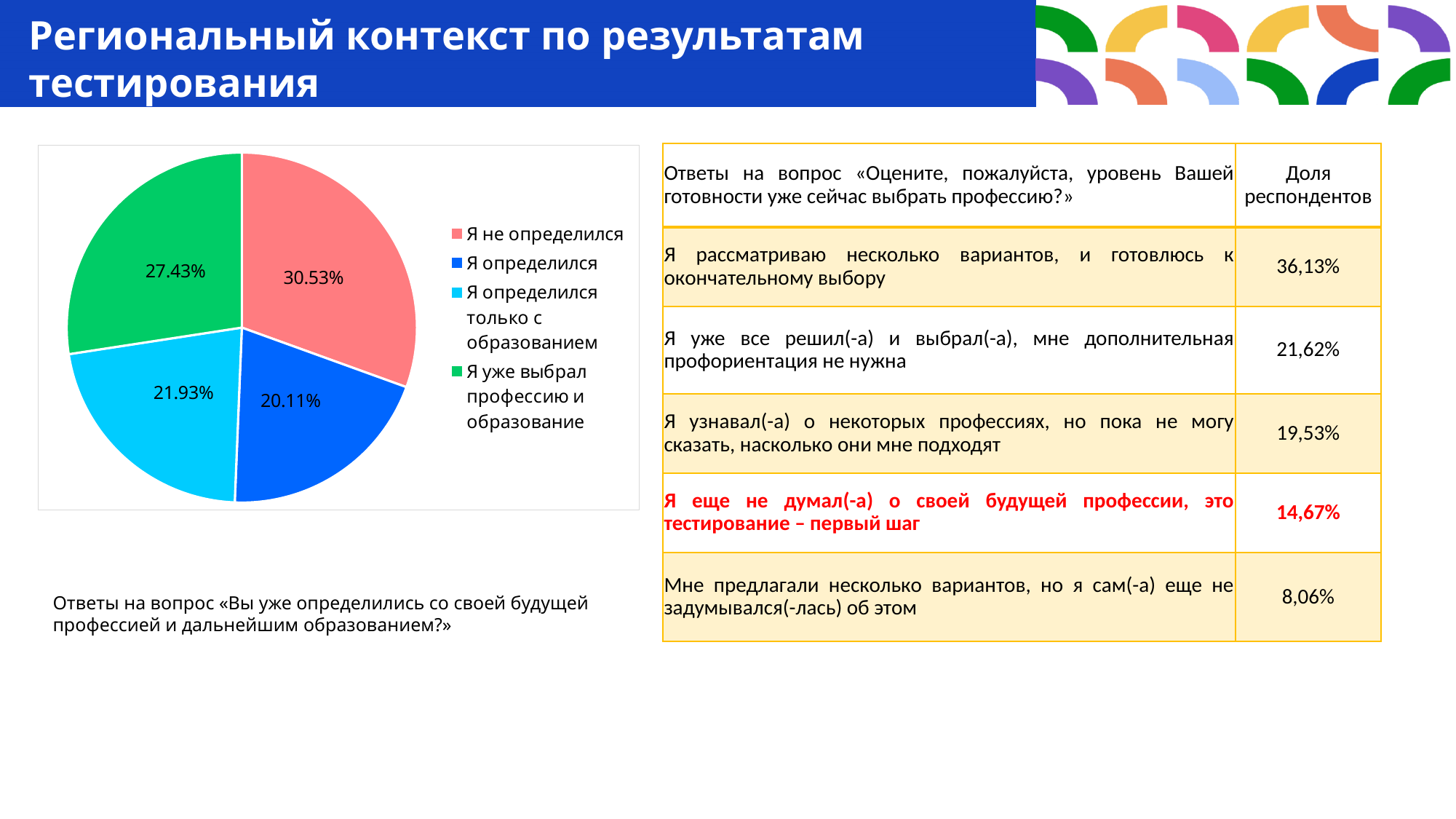
Which slice of the pie chart is the smallest? Я определился What share of the pie chart is labelled "Я определился только с образованием"? 21.93% Which is larger in the pie chart: "Я уже выбрал профессию и образование" or "Я определился только с образованием"? Я уже выбрал профессию и образование What colour is the "Я уже выбрал профессию и образование" slice in the pie chart? green How many entries does the pie chart legend list? 4 What is the difference between the "Я не определился" slice and the "Я определился" slice in the pie chart? 10.42% What share of the pie chart is labelled "Я не определился"? 30.53% Which slice of the pie chart is the largest? Я не определился How many slices does the pie chart have? 4 What kind of chart is shown on the slide? pie chart What share of the pie chart is labelled "Я уже выбрал профессию и образование"? 27.43% What share of the pie chart is labelled "Я определился"? 20.11%